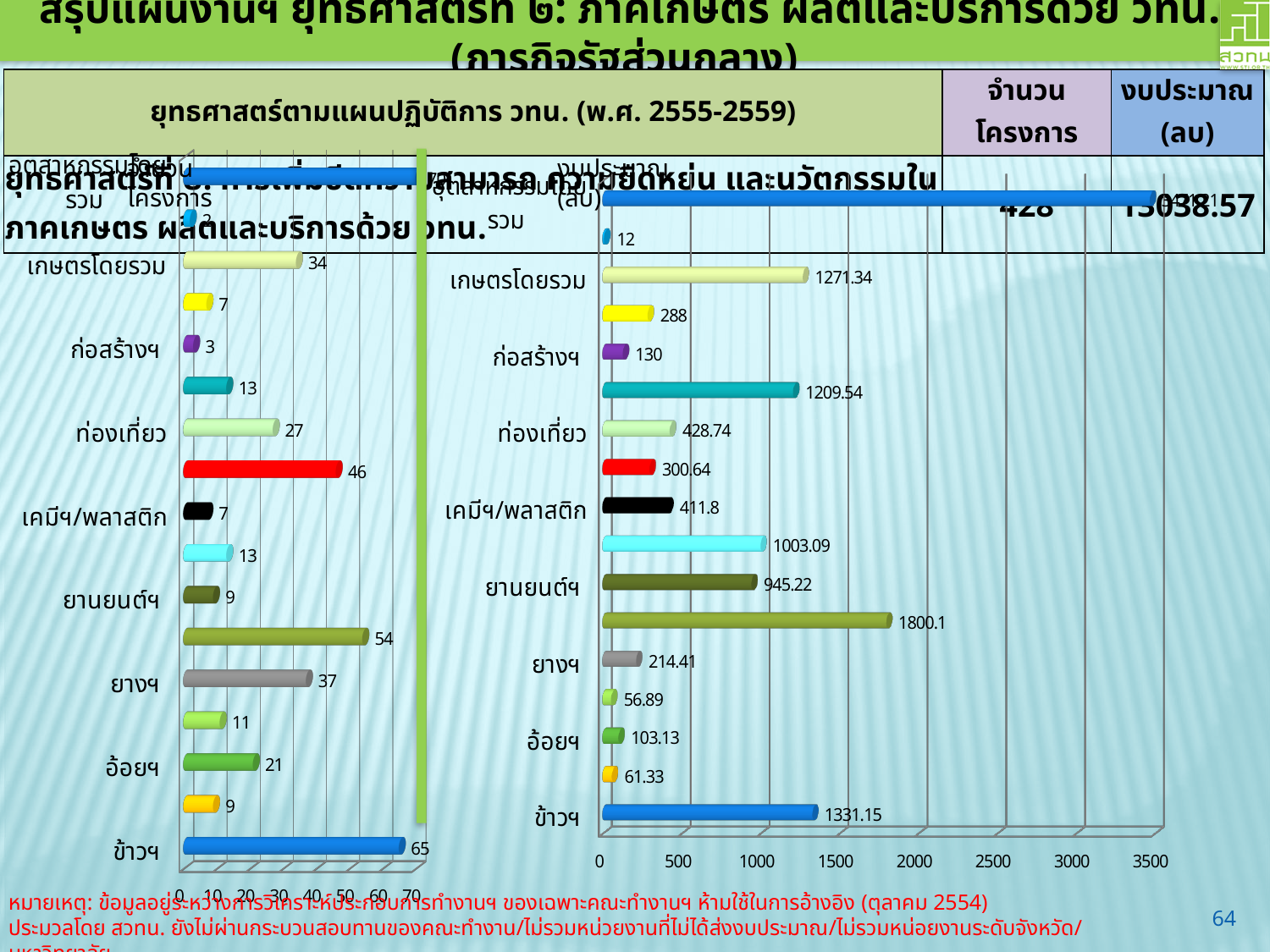
On the left chart (จำนวนโครงการ), what is the value labeled on the blue bar next to ข้าวฯ? 65 On the right chart (งบประมาณ), what is the highest value shown on the x axis? 3500 On the left chart (จำนวนโครงการ), what is the difference between the red bar (46) and the black bar (7)? 39 How many category labels are listed on the y axis of the right chart (งบประมาณ)? 9 On the right chart (งบประมาณ), what is the value labeled on the blue bar next to ข้าวฯ? 1331.15 On the left chart (จำนวนโครงการ), what is the value labeled on the red bar? 46 On the right chart (งบประมาณ), is the value of the teal bar (1209.54) greater or less than 1000? greater What kind of chart is the left chart (จำนวนโครงการ)? bar chart On the right chart (งบประมาณ), which is larger: the red bar or the black bar? the black bar On the left chart (จำนวนโครงการ), what is the highest value shown on the x axis? 70 On the right chart (งบประมาณ), what is the value labeled on the longest olive-green bar? 1800.1 On the right chart (งบประมาณ), what is the difference between the blue bar (1331.15) and the yellow bar (61.33)? 1269.82